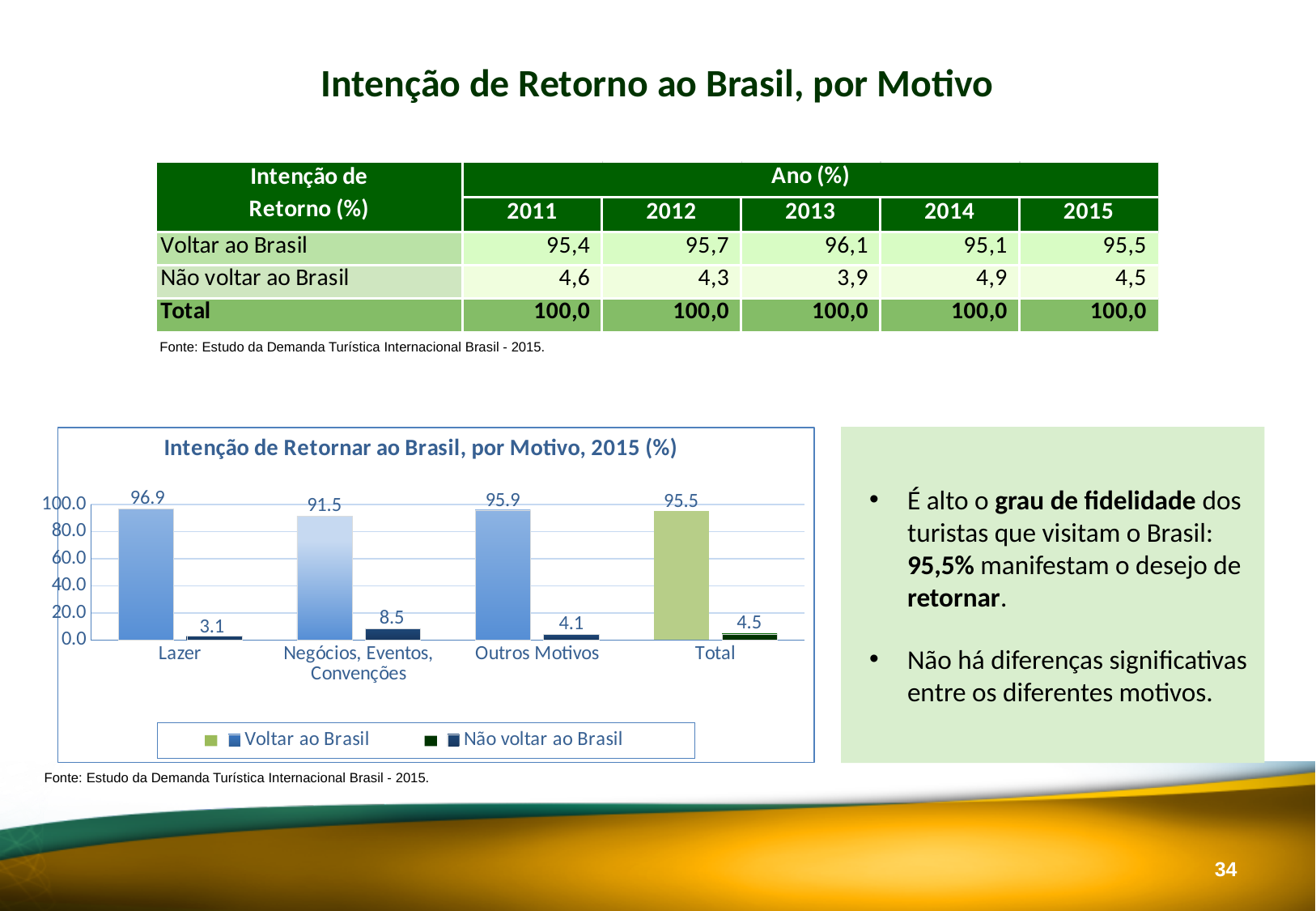
What is the value for Total in the Não voltar ao Brasil series? 4.5 What kind of chart is shown on the slide? Bar chart What is the title of the chart? Intenção de Retornar ao Brasil, por Motivo, 2015 (%) Which category has the lowest value in the Não voltar ao Brasil series? Lazer What is the value for Lazer in the Voltar ao Brasil series? 96.9 What is the value for Negócios, Eventos, Convenções in the Não voltar ao Brasil series? 8.5 What is the value for Outros Motivos in the Voltar ao Brasil series? 95.9 What is the difference between the Voltar ao Brasil values for Lazer and Negócios, Eventos, Convenções? 5.4 How many series does the chart legend list? 2 How many categories are shown on the x axis of the chart? 4 Which is larger in the Não voltar ao Brasil series: Negócios, Eventos, Convenções or Outros Motivos? Negócios, Eventos, Convenções Which category has the highest value in the Voltar ao Brasil series? Lazer